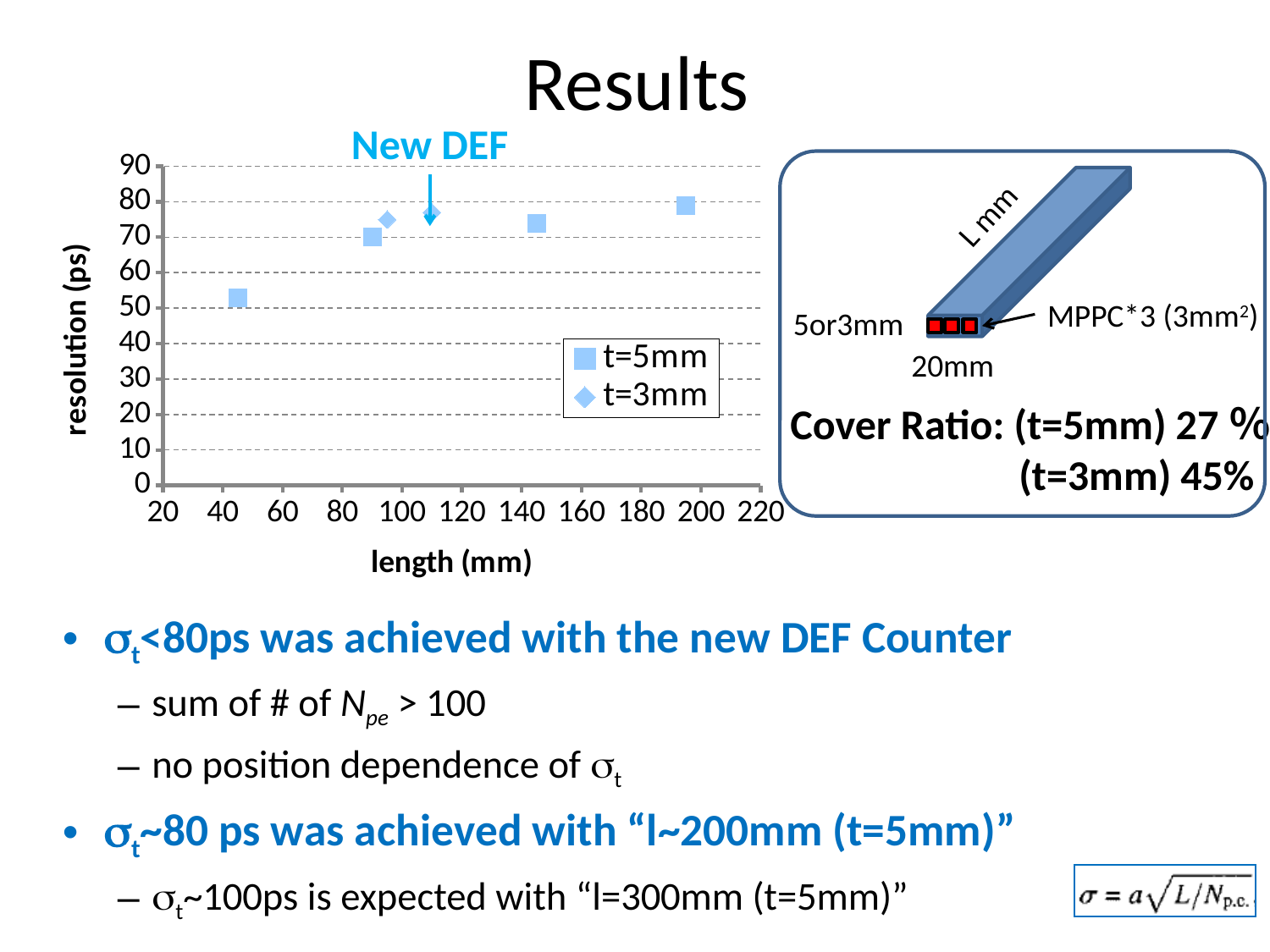
Do the t=5mm resolution values rise or fall as length increases along the x axis? rise What are the two series named in the chart legend? t=5mm and t=3mm Which t=5mm point has the lowest resolution: the one near 40 mm or the one near 200 mm? the one near 40 mm Is the resolution of the t=5mm point at the shortest length (around 40 mm) greater or less than 60 ps? less How many data points are plotted for the t=3mm series? 2 What kind of chart is shown on the slide? scatter chart Is the resolution of the t=5mm point near 90 mm greater or less than 60 ps? greater What is the label of the vertical axis of the chart? resolution (ps) Is the resolution of the t=5mm point at the longest length (around 200 mm) greater or less than 70 ps? greater How many data points are plotted for the t=5mm series? 4 How many series does the chart legend list? 2